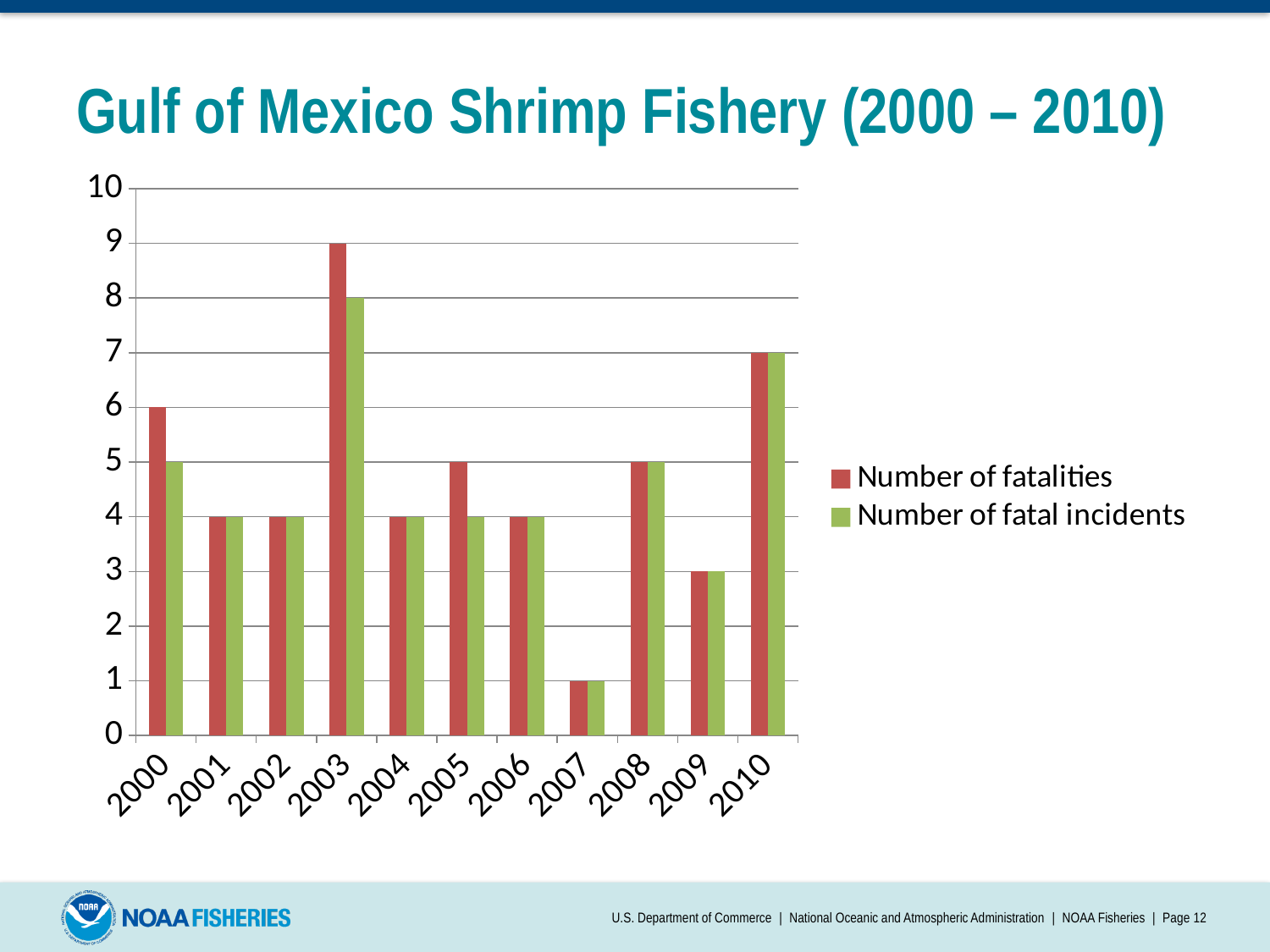
How many years are shown on the x axis? 11 What kind of chart is shown on the slide? Bar chart Which is larger in 2005: the number of fatalities or the number of fatal incidents? Number of fatalities What is the number of fatal incidents in 2000? 5 What is the difference between the number of fatalities and the number of fatal incidents in 2003? 1 What is the title of the chart? Gulf of Mexico Shrimp Fishery (2000 – 2010) Is the number of fatalities in 2003 greater or less than 8? greater Which year has the highest number of fatalities? 2003 Which year has the lowest number of fatal incidents? 2007 What is the number of fatalities in 2010? 7 What is the number of fatalities in 2003? 9 How many series does the legend list? 2